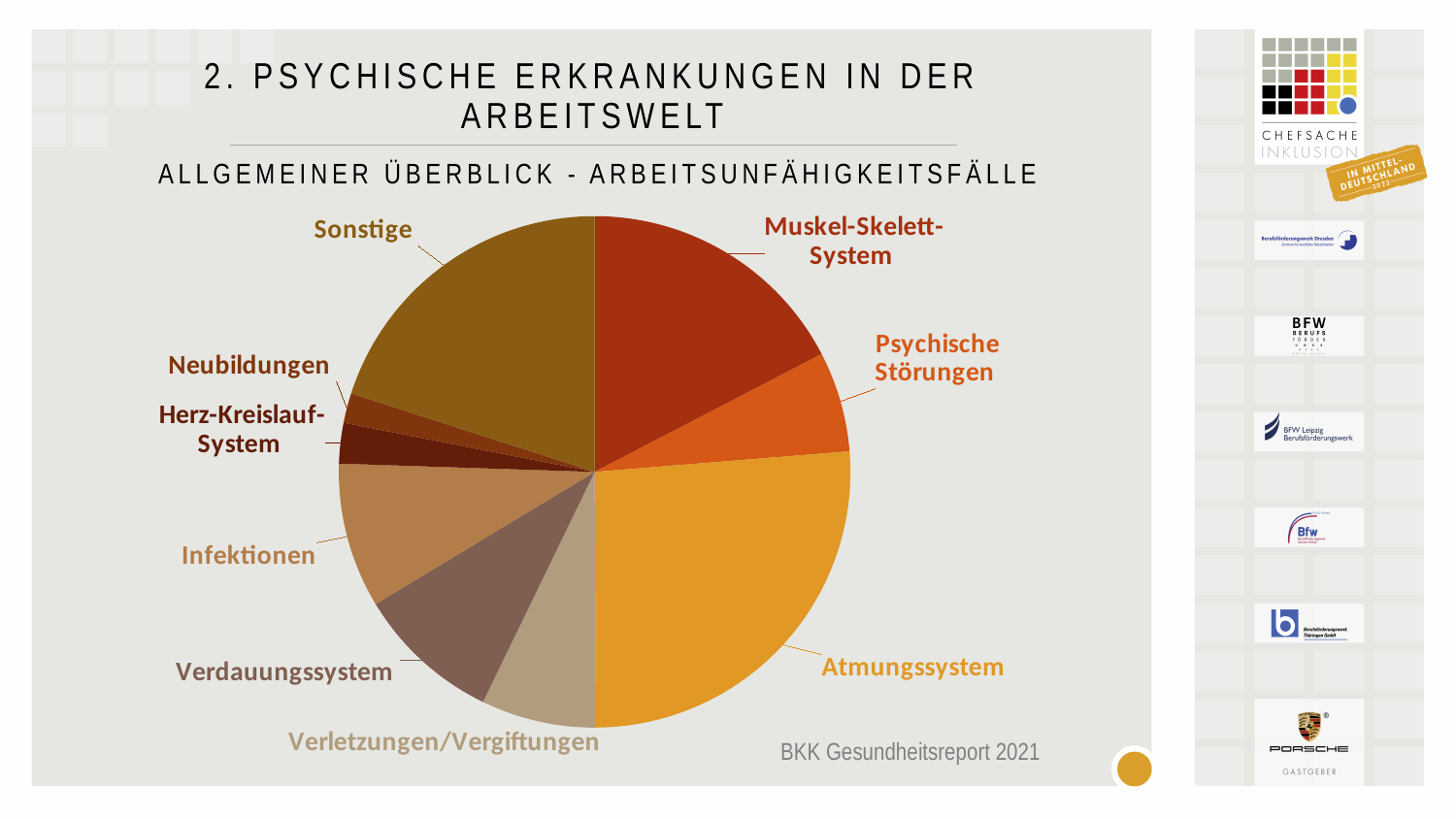
Which slice is larger, Sonstige or Infektionen? Sonstige Which category has the largest slice in the pie chart? Atmungssystem Which slice is larger, Muskel-Skelett-System or Neubildungen? Muskel-Skelett-System Which slice is larger, Atmungssystem or Verdauungssystem? Atmungssystem What is the subtitle shown above the pie chart? Allgemeiner Überblick - Arbeitsunfähigkeitsfälle How many categories (slices) does the pie chart have? 9 What source is cited below the pie chart? BKK Gesundheitsreport 2021 What kind of chart is shown on the slide? pie chart